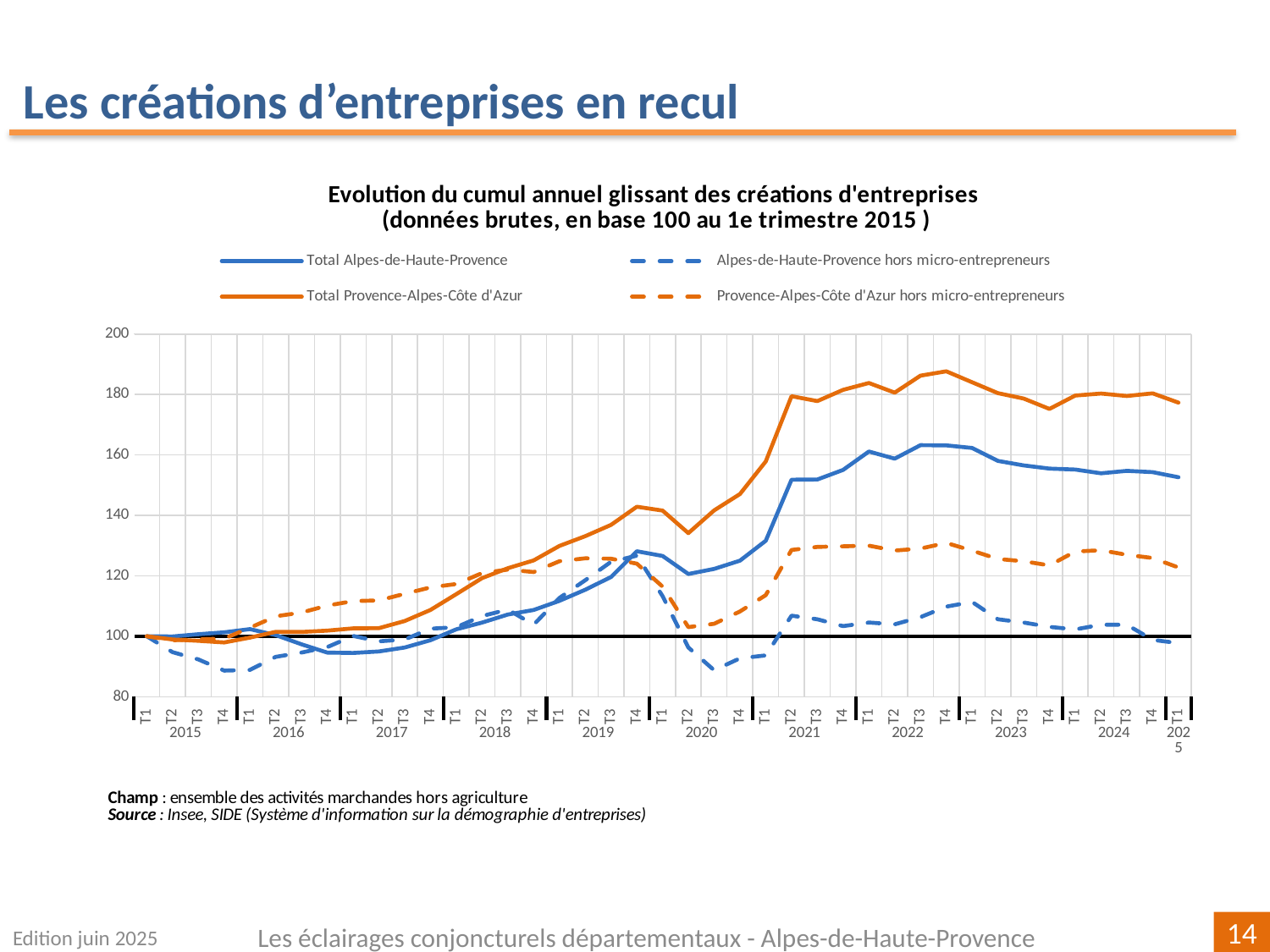
What is the title of the chart? Evolution du cumul annuel glissant des créations d'entreprises (données brutes, en base 100 au 1e trimestre 2015 ) Is the value for Total Alpes-de-Haute-Provence at T1 2025 greater or less than 140? greater Does the Total Provence-Alpes-Côte d'Azur series rise or fall between T1 2015 and T4 2022? rise Is the value for Total Provence-Alpes-Côte d'Azur at T4 2022 greater or less than 180? greater At T4 2015, which is higher: Alpes-de-Haute-Provence hors micro-entrepreneurs or Provence-Alpes-Côte d'Azur hors micro-entrepreneurs? Provence-Alpes-Côte d'Azur hors micro-entrepreneurs Is the value for Alpes-de-Haute-Provence hors micro-entrepreneurs at T3 2020 greater or less than 100? less What kind of chart is shown on the slide? line chart How many series does the legend list? 4 At T1 2025, which is higher: Total Provence-Alpes-Côte d'Azur or Total Alpes-de-Haute-Provence? Total Provence-Alpes-Côte d'Azur Which series reaches the highest value on the chart? Total Provence-Alpes-Côte d'Azur Which series is drawn as a dashed orange line? Provence-Alpes-Côte d'Azur hors micro-entrepreneurs